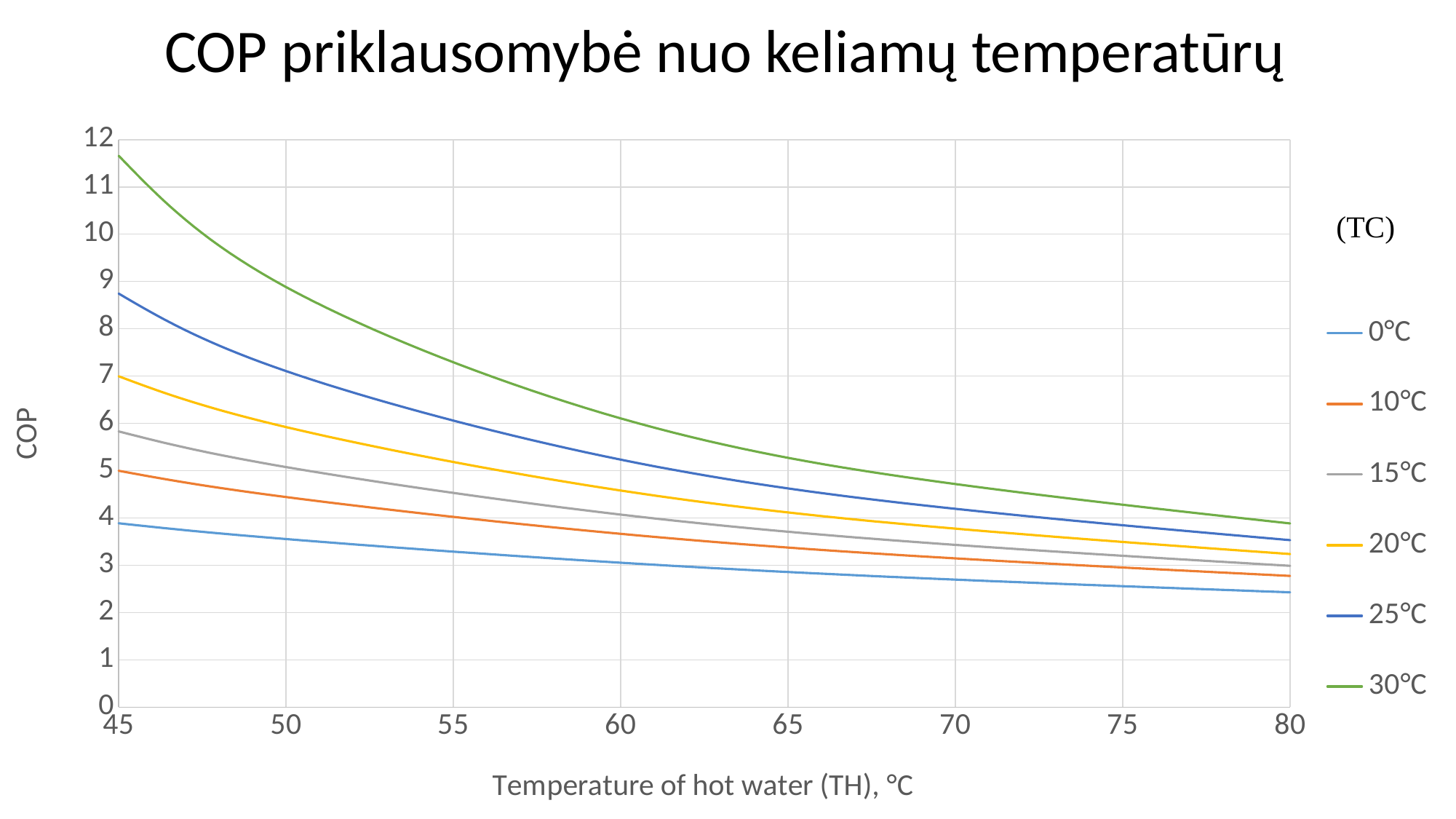
Is the COP for the 30°C series at a hot water temperature of 45 greater or less than 10? greater Which series has the highest COP at a hot water temperature of 45? 30°C What is the title of the chart? COP priklausomybė nuo keliamų temperatūrų At a hot water temperature of 60, which series has the higher COP, 30°C or 25°C? 30°C Which series has the lowest COP at a hot water temperature of 80? 0°C Does the COP for the 30°C series rise or fall as the hot water temperature increases from 45 to 80? fall How many series does the legend list? 6 What kind of chart is shown on the slide? line chart What is the label of the x axis? Temperature of hot water (TH), °C Is the COP for the 20°C series at a hot water temperature of 80 greater or less than 4? less Is the COP for the 0°C series at a hot water temperature of 80 greater or less than 3? less